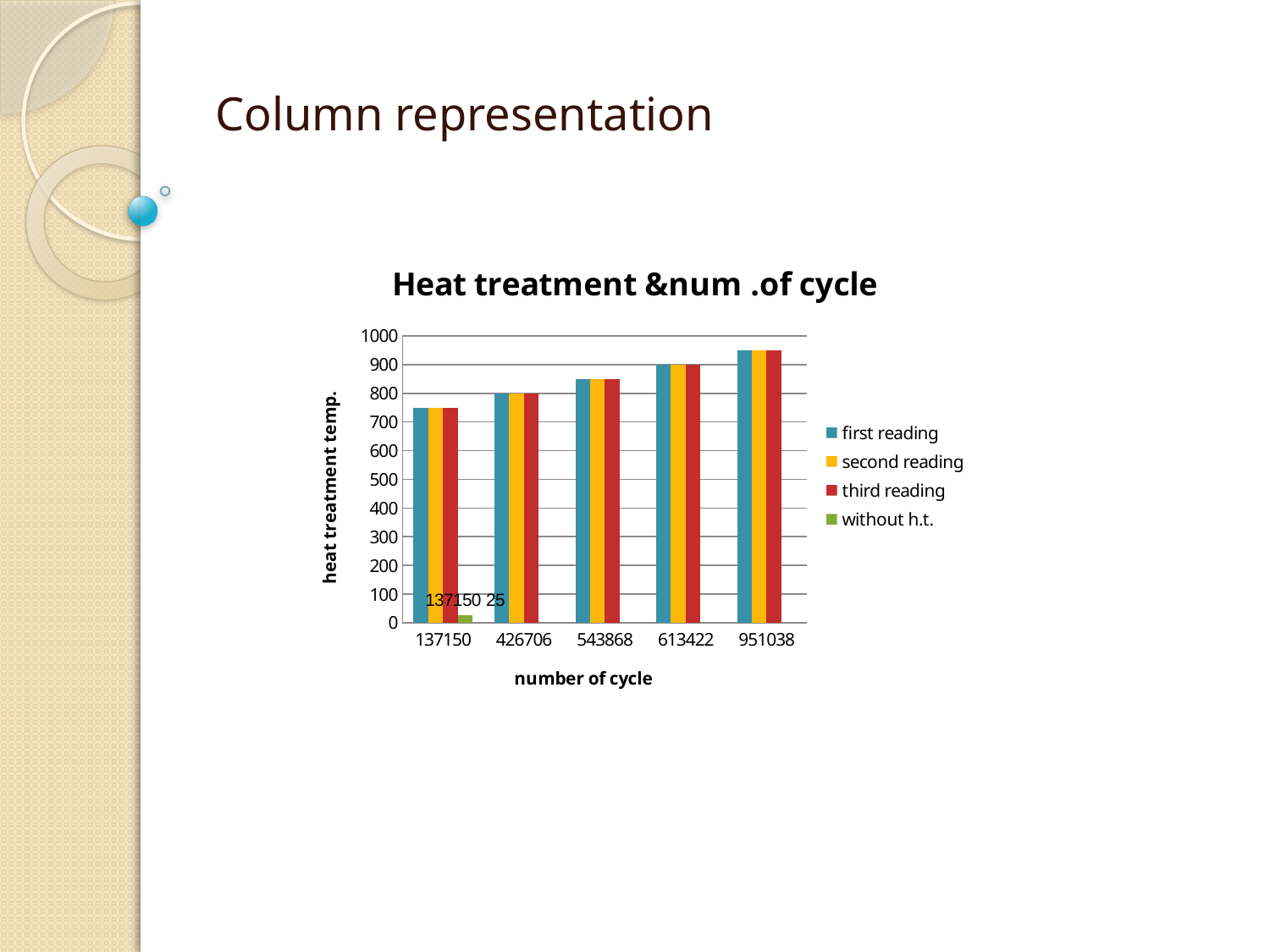
What is the title of the chart? Heat treatment &num .of cycle Is the second reading for 137150 cycles greater or less than 800? less How many number-of-cycle categories are shown on the x axis? 5 What is the value of the 'without h.t.' series at 137150 cycles, as printed on the chart? 25 What is the third reading value for 613422 cycles? 900 Is the first reading for 951038 cycles greater or less than 900? greater How many series does the legend list? 4 Which number of cycles has the highest first reading? 951038 Which number of cycles has the lowest second reading? 137150 What is the first reading value for 426706 cycles? 800 What type of chart is shown on the slide? bar chart Do the first reading values rise or fall as the number of cycles increases along the x axis? rise